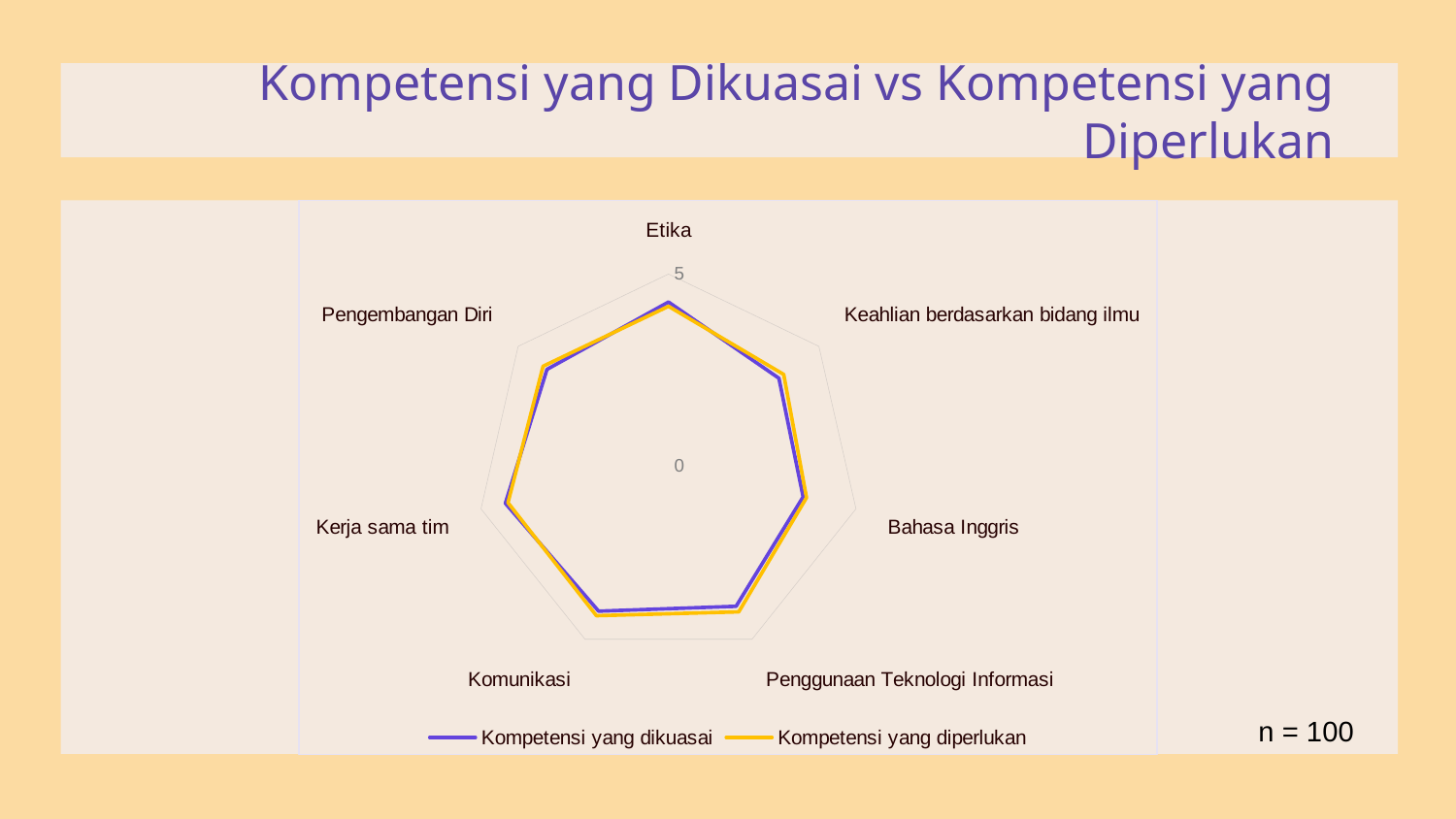
Is the value for Bahasa Inggris in the Kompetensi yang diperlukan series greater or less than 5? less How many series does the legend list? 2 Is the value for Komunikasi in the Kompetensi yang diperlukan series greater or less than 5? less How many competency categories are plotted on the radar chart? 7 What kind of chart is shown on the slide? Radar chart Is the value for Etika in the Kompetensi yang dikuasai series greater or less than 5? less Which series is drawn in yellow according to the legend? Kompetensi yang diperlukan What is the title of the chart on the slide? Kompetensi yang Dikuasai vs Kompetensi yang Diperlukan What is the maximum value shown on the radar chart's axis? 5